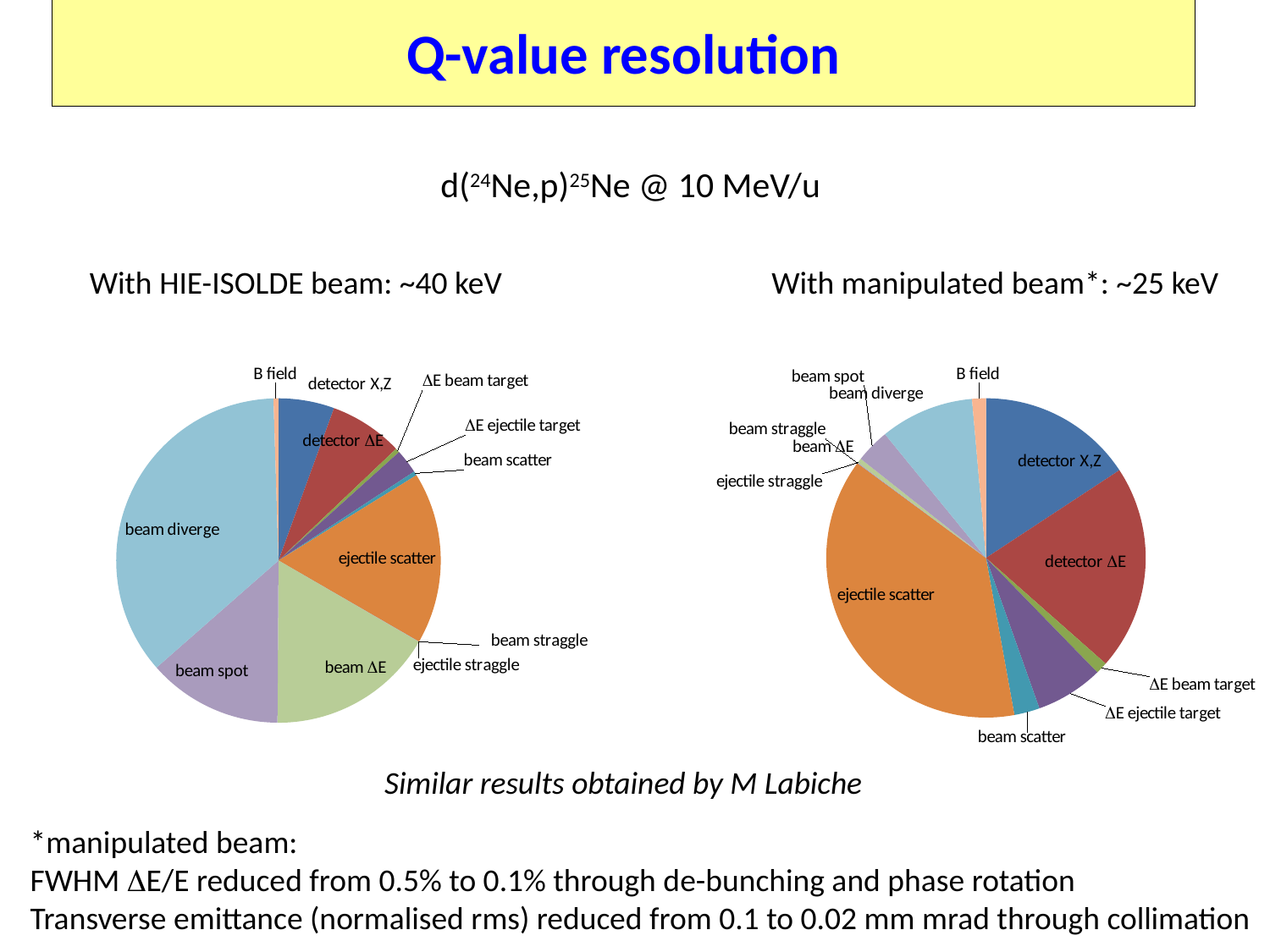
In the pie chart under "With manipulated beam*: ~25 keV", which slice is larger, ejectile scatter or detector ΔE? ejectile scatter In the pie chart under "With manipulated beam*: ~25 keV", which category has the largest slice? ejectile scatter How many slices does the pie chart under "With manipulated beam*: ~25 keV" have? 12 In the pie chart under "With HIE-ISOLDE beam: ~40 keV", which category has the largest slice? beam diverge In the pie chart under "With HIE-ISOLDE beam: ~40 keV", which slice is larger, ejectile scatter or B field? ejectile scatter What kind of chart is shown under "With manipulated beam*: ~25 keV"? pie chart How many pie charts are shown on the slide? 2 How many slices does the pie chart under "With HIE-ISOLDE beam: ~40 keV" have? 12 What kind of chart is shown under "With HIE-ISOLDE beam: ~40 keV"? pie chart In the pie chart under "With HIE-ISOLDE beam: ~40 keV", which slice is larger, beam diverge or beam spot? beam diverge What is the title of the slide containing the two pie charts? Q-value resolution